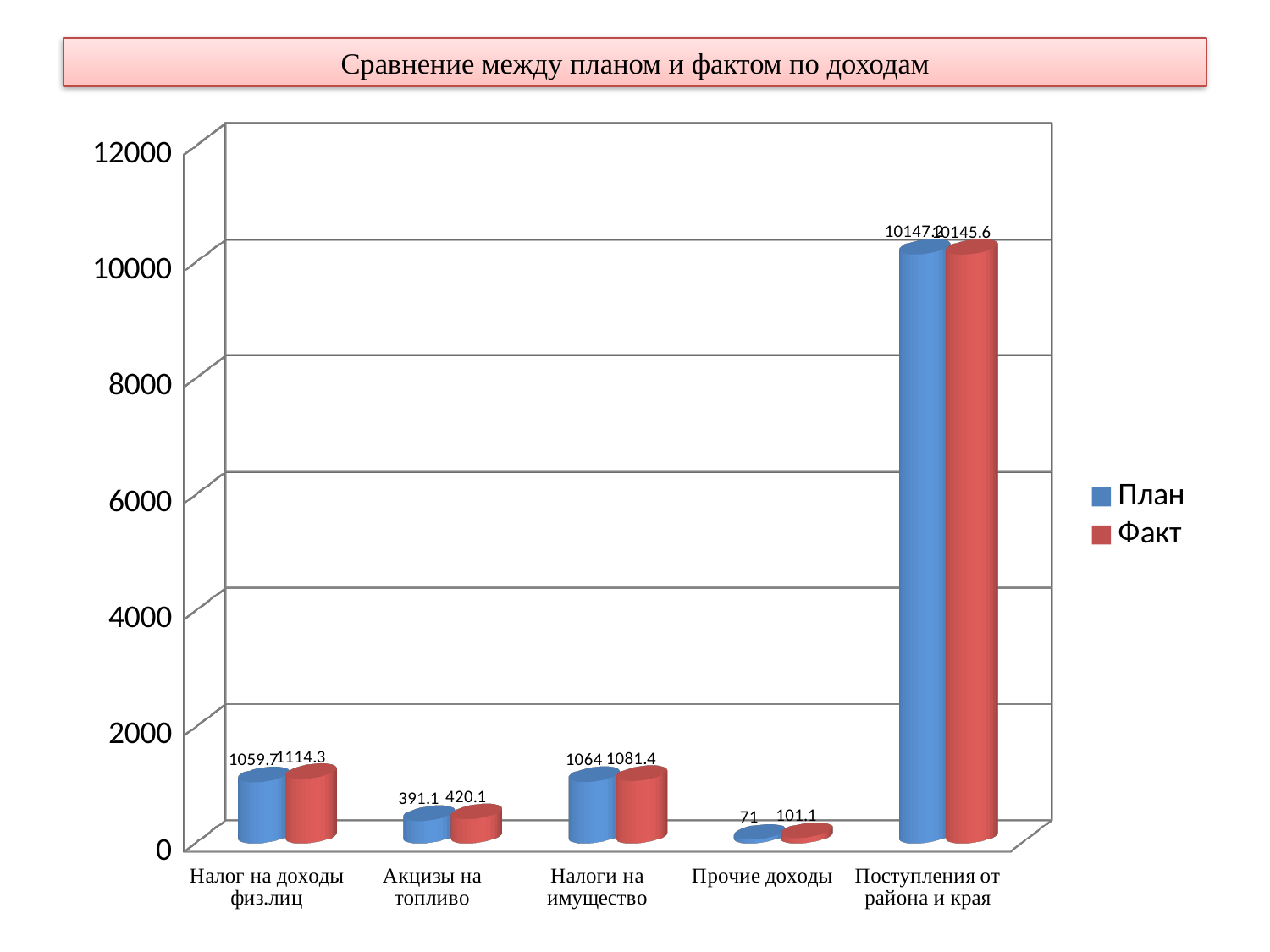
What is the План value for Акцизы на топливо? 391.1 What is the Факт value for Прочие доходы? 101.1 What type of chart is shown on the slide? bar chart How many categories are shown on the x axis? 5 What is the title of the slide? Сравнение между планом и фактом по доходам Which category has the lowest План value? Прочие доходы What is the План value for Налоги на имущество? 1064 What is the Факт value for Налог на доходы физ.лиц? 1114.3 Which is larger for Прочие доходы, the План value or the Факт value? Факт Which category has the highest Факт value? Поступления от района и края What is the difference between the Факт and План values for Акцизы на топливо? 29 How many series does the legend list? 2